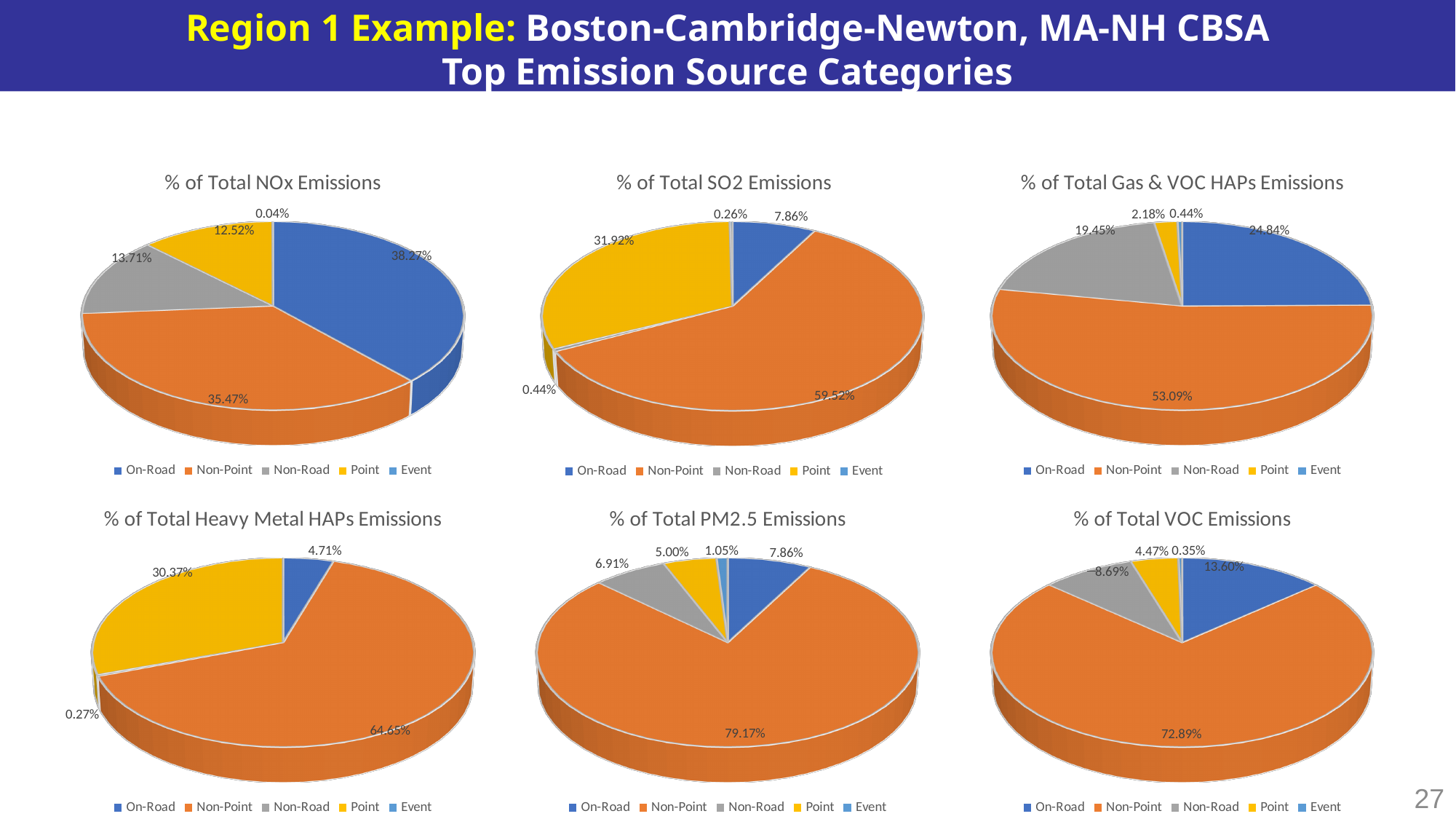
In the '% of Total NOx Emissions' chart, what share is On-Road? 38.27% In the '% of Total PM2.5 Emissions' chart, what share is Non-Point? 79.17% In the '% of Total Gas & VOC HAPs Emissions' chart, what share is Non-Road? 19.45% In the '% of Total VOC Emissions' chart, what share is On-Road? 13.60% In the '% of Total SO2 Emissions' chart, what is the difference between the Non-Point and Point shares? 27.60% In the '% of Total PM2.5 Emissions' chart, which category has the smallest share? Event In the '% of Total Gas & VOC HAPs Emissions' chart, which is larger, On-Road or Non-Road? On-Road What kind of chart is the '% of Total NOx Emissions' chart? Pie chart In the '% of Total Heavy Metal HAPs Emissions' chart, what share is Point? 30.37% In the '% of Total SO2 Emissions' chart, what share is Point? 31.92% How many series does the legend of the '% of Total VOC Emissions' chart list? 5 In the '% of Total NOx Emissions' chart, which category has the largest share? On-Road